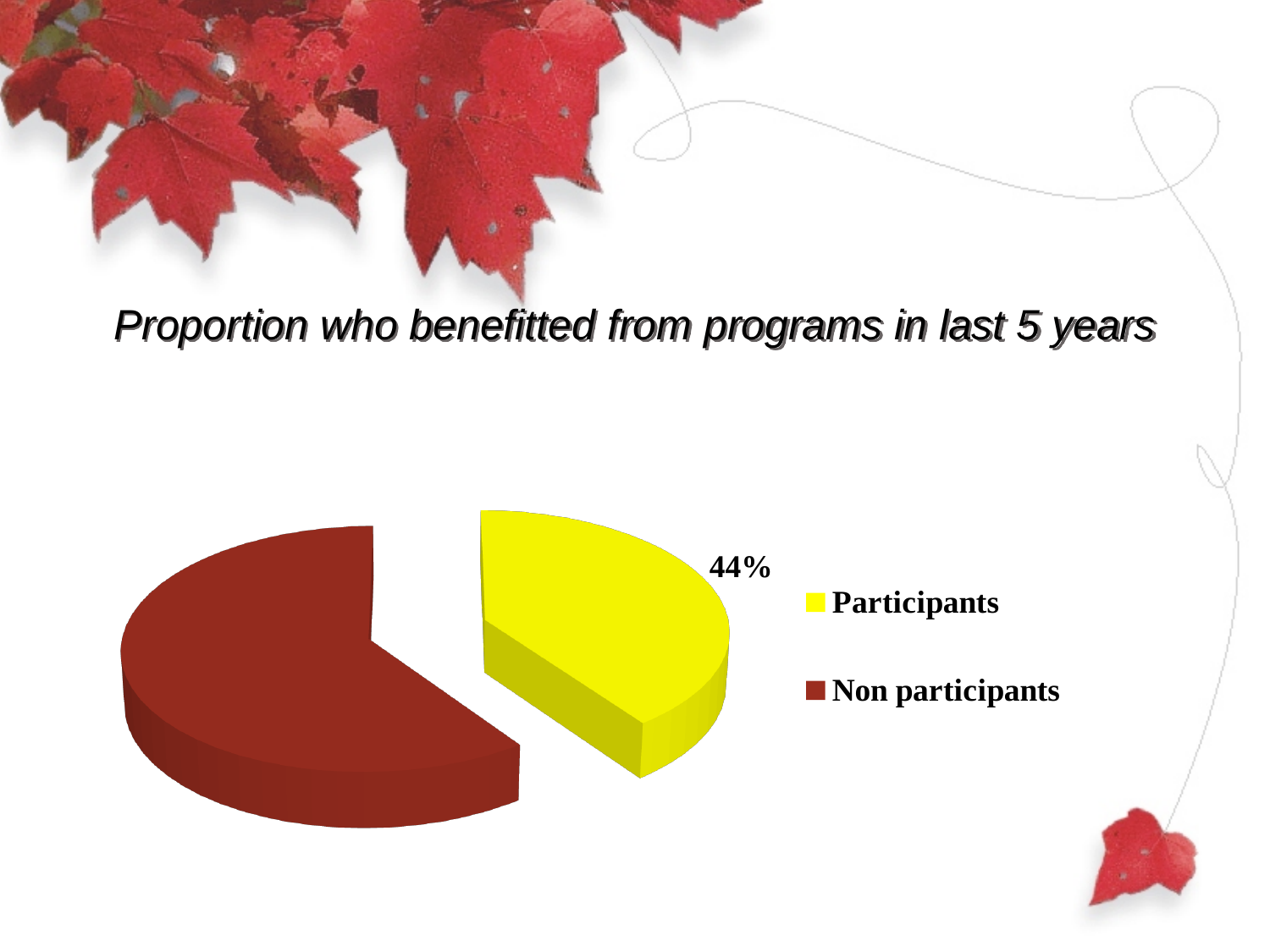
What kind of chart is shown on the slide? pie chart Which slice is the largest in the pie chart? Non participants How many slices does the pie chart have? 2 What share of the pie does the Participants slice represent? 44% Which is larger, the Participants slice or the Non participants slice? Non participants What is the title of the chart? Proportion who benefitted from programs in last 5 years What colour is the Participants slice? yellow What percentage of the pie is labelled for Participants? 44% How many entries does the legend list? 2 Which slice is the smallest in the pie chart? Participants